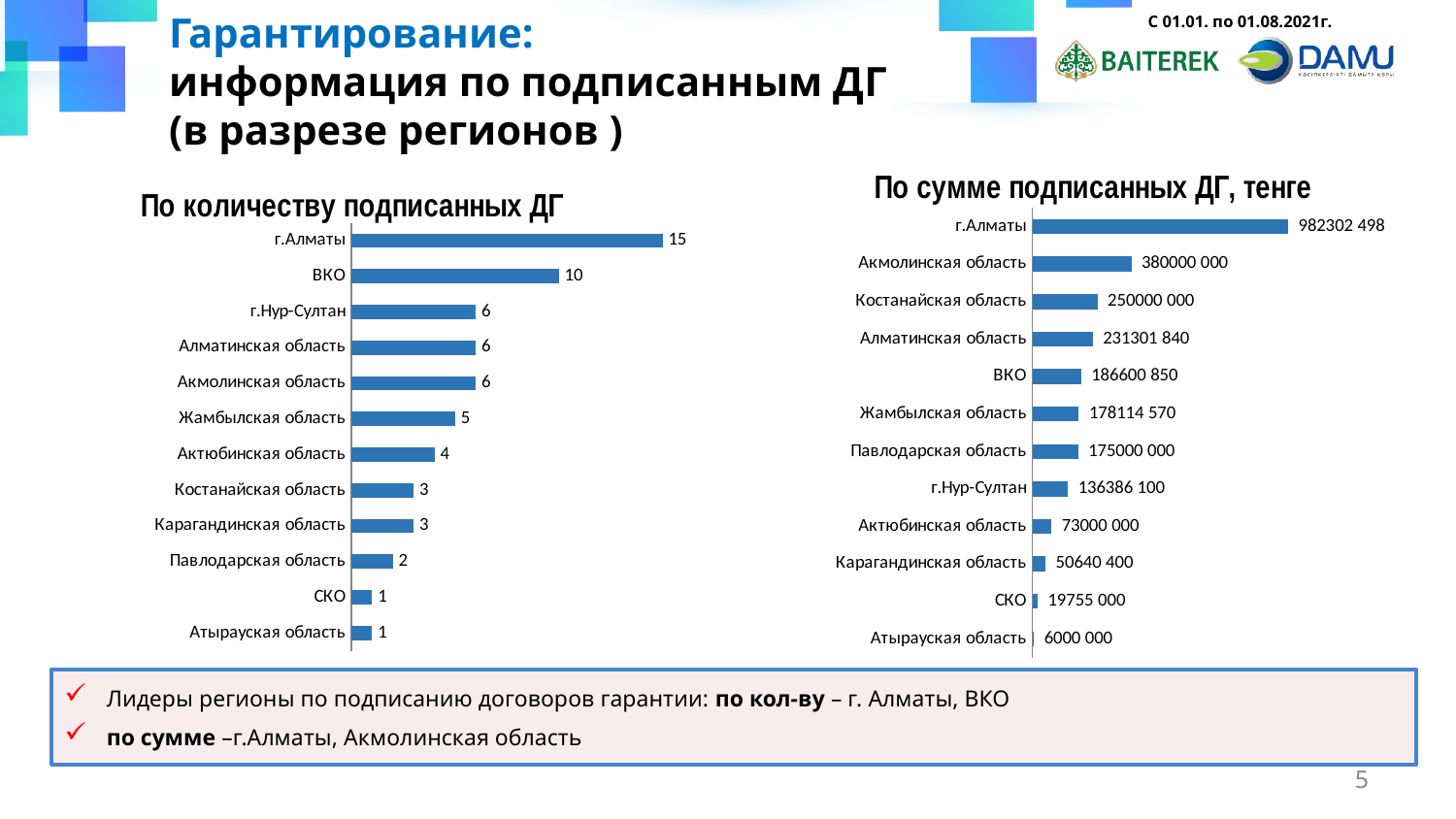
In the chart 'По сумме подписанных ДГ, тенге', which is larger: the value for ВКО or Костанайская область? Костанайская область In the chart 'По количеству подписанных ДГ', what is the value for Жамбылская область? 5 In the chart 'По количеству подписанных ДГ', which is larger: the value for Актюбинская область or Павлодарская область? Актюбинская область In the chart 'По сумме подписанных ДГ, тенге', what is the value for СКО? 19755 000 In the chart 'По количеству подписанных ДГ', what is the value for г.Алматы? 15 In the chart 'По количеству подписанных ДГ', which region has the highest value? г.Алматы What kind of chart is 'По сумме подписанных ДГ, тенге'? bar chart In the chart 'По сумме подписанных ДГ, тенге', which region has the lowest value? Атырауская область In the chart 'По сумме подписанных ДГ, тенге', what is the value for Акмолинская область? 380000 000 In the chart 'По количеству подписанных ДГ', what is the difference between the values for г.Алматы and ВКО? 5 In the chart 'По сумме подписанных ДГ, тенге', what is the value for г.Нур-Султан? 136386 100 In the chart 'По количеству подписанных ДГ', how many regions are shown? 12